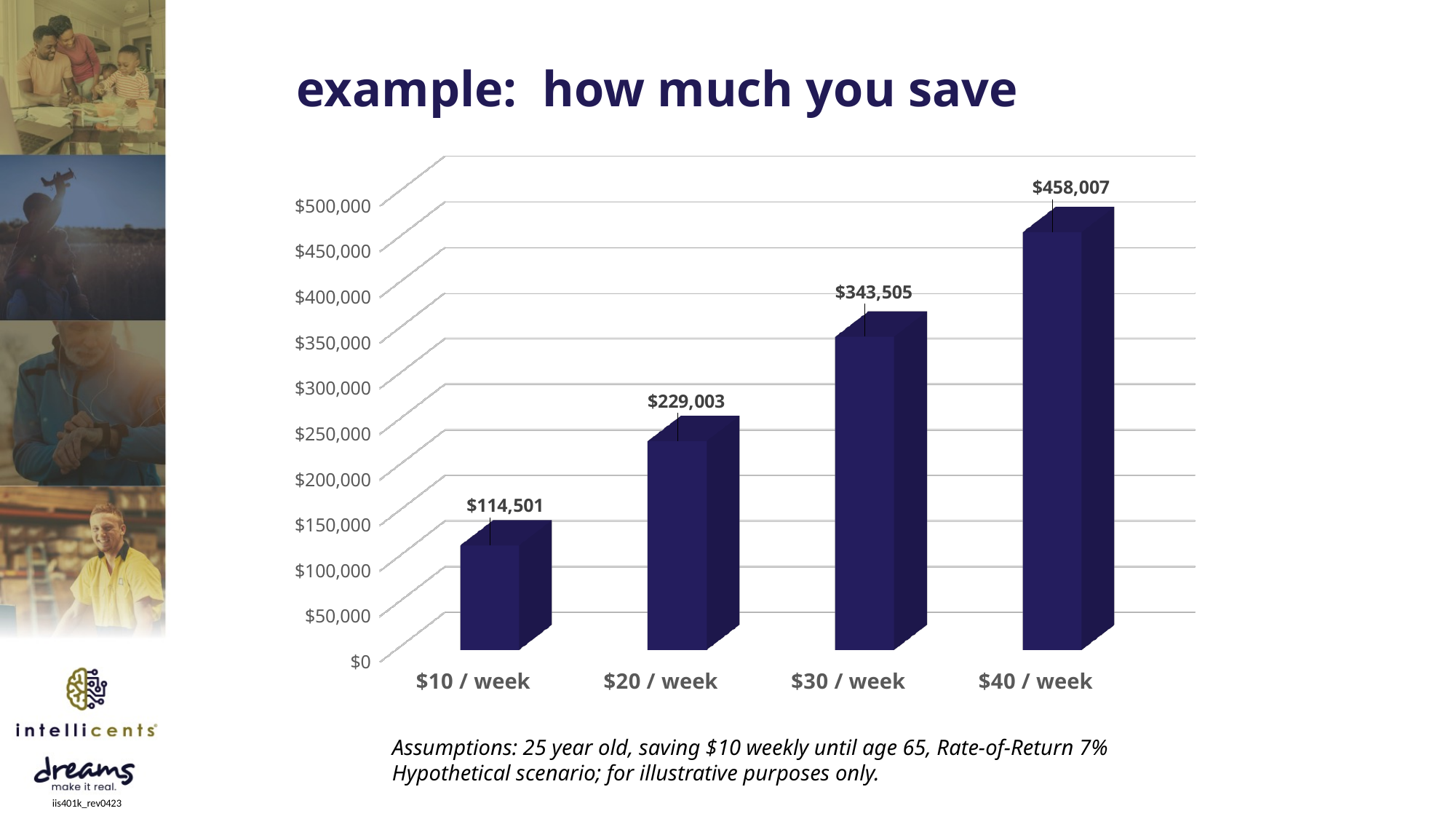
Which category has the lowest value? $10 / week What is the value for $40 / week? $458,007 What is the value for $20 / week? $229,003 Which is larger, the value for $20 / week or the value for $30 / week? $30 / week Which category has the highest value? $40 / week Do the values rise or fall from $10 / week to $40 / week? Rise What is the difference between the values for $30 / week and $20 / week? $114,502 How many categories are shown on the x axis? 4 What kind of chart is shown on the slide? Bar chart What is the value for $30 / week? $343,505 What is the difference between the values for $40 / week and $10 / week? $343,506 What is the value for $10 / week? $114,501